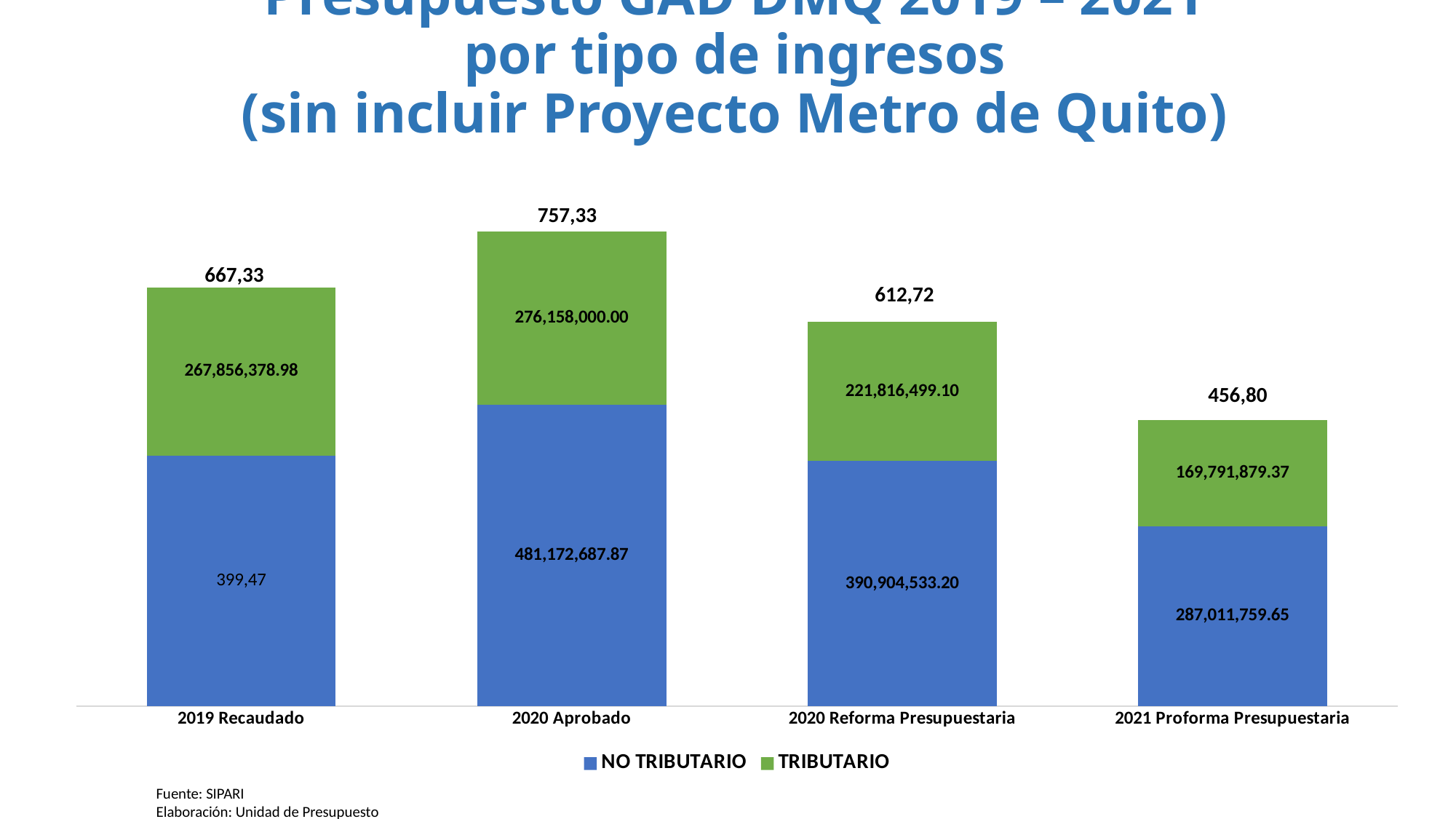
What is the NO TRIBUTARIO value for 2021 Proforma Presupuestaria? 287,011,759.65 What is the TRIBUTARIO value for 2020 Aprobado? 276,158,000.00 What kind of chart is shown on the slide? Stacked bar chart Which category has the highest total bar? 2020 Aprobado What total is printed above the 2020 Reforma Presupuestaria bar? 612,72 What is the difference between the TRIBUTARIO values for 2020 Aprobado and 2020 Reforma Presupuestaria? 54,341,500.90 Which is larger, the NO TRIBUTARIO value for 2020 Reforma Presupuestaria or for 2021 Proforma Presupuestaria? 2020 Reforma Presupuestaria How many series does the legend list? 2 How many categories are shown on the x axis? 4 Which category has the lowest total bar? 2021 Proforma Presupuestaria Do the total bar values rise or fall from 2020 Aprobado to 2021 Proforma Presupuestaria? Fall Which series is shown in green in the legend? TRIBUTARIO